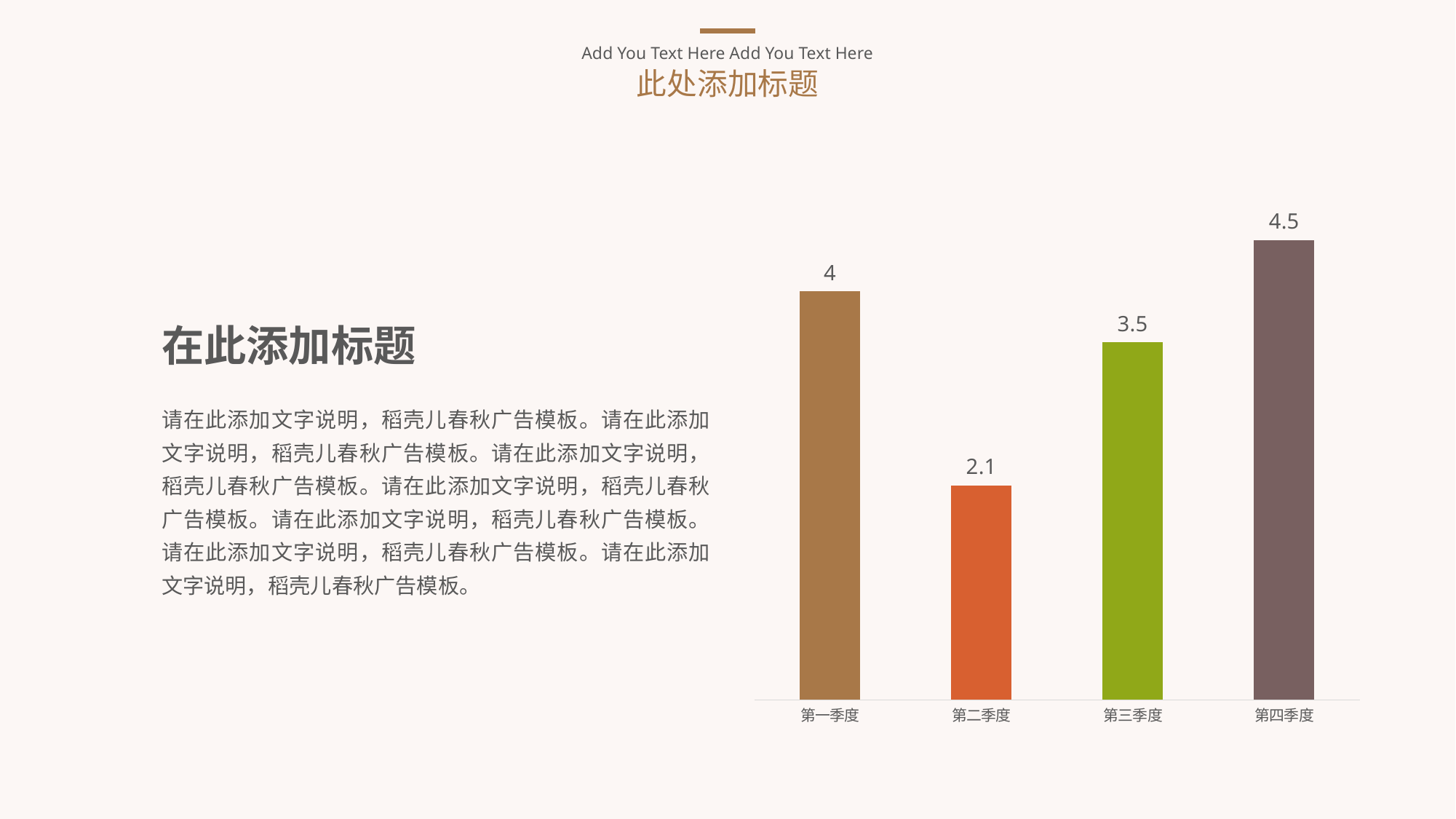
Which category has the highest value? 第四季度 Which category has the lowest value? 第二季度 What is the difference between the values for 第一季度 and 第三季度? 0.5 What kind of chart is shown on the slide? bar chart How many categories are shown in the chart? 4 What is the difference between the values for 第四季度 and 第二季度? 2.4 What is the value for 第四季度? 4.5 Which is larger, the value for 第一季度 or the value for 第三季度? 第一季度 What is the value for 第三季度? 3.5 What is the value for 第二季度? 2.1 What colour is the bar for 第三季度? green What is the value for 第一季度? 4